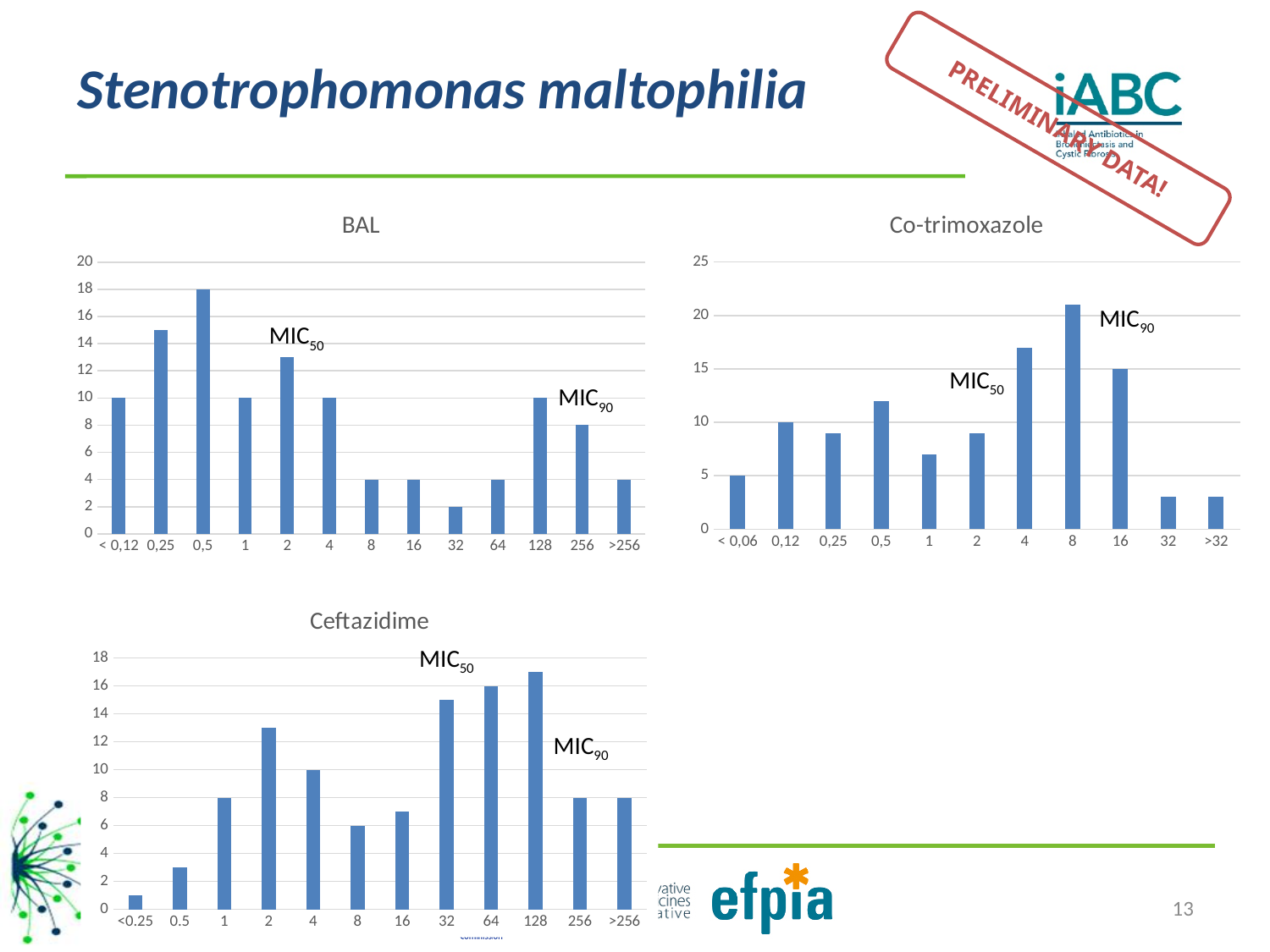
In the Co-trimoxazole chart, is the value for the 4 category greater or less than 15? greater In the BAL chart, which category has the highest bar? 0,5 What kind of chart is the Ceftazidime chart? Bar chart In the Co-trimoxazole chart, which category has the highest bar? 8 In the BAL chart, which category has the lowest bar? 32 In the Ceftazidime chart, what is the value for the 64 category? 16 In the Ceftazidime chart, which is larger, the value for 128 or the value for 256? 128 How many categories are shown on the x axis of the Co-trimoxazole chart? 11 In the BAL chart, what is the value for the 0,5 category? 18 In the BAL chart, what is the difference between the values for 0,5 and 128? 8 In the Ceftazidime chart, which category has the lowest bar? <0.25 In the Co-trimoxazole chart, what is the value for the 16 category? 15